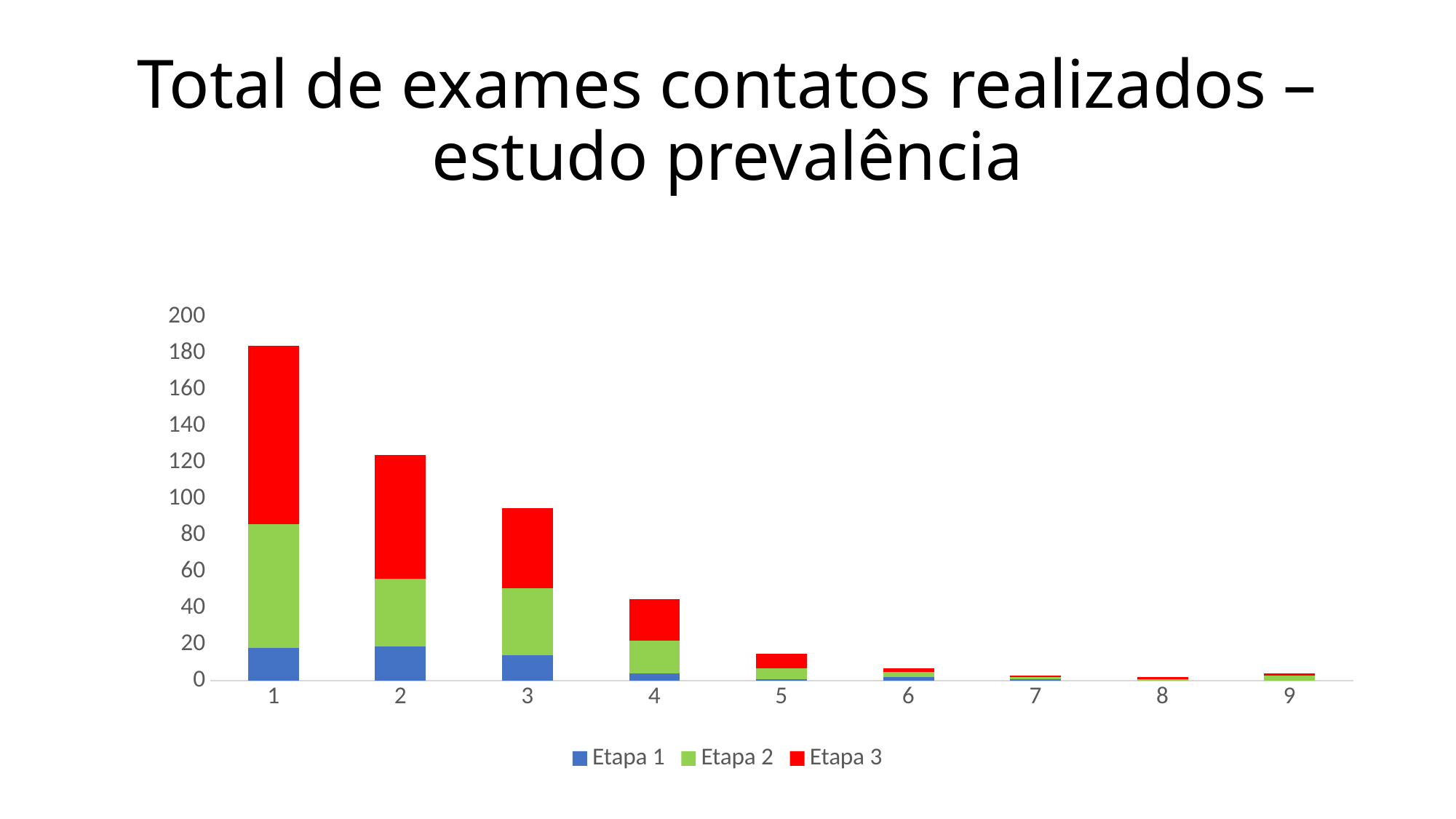
Do the bar totals rise or fall from category 1 to category 5? fall Which colour represents Etapa 3 in the chart? red Which category has the tallest stacked bar? 1 Is the total of the stacked bar for category 5 greater or less than 20? less Which stacked bar is taller, category 2 or category 3? 2 Is the total of the stacked bar for category 1 greater or less than 160? greater Is the total of the stacked bar for category 2 greater or less than 100? greater What kind of chart is shown on the slide? stacked bar chart How many series does the legend list? 3 How many categories are shown on the x axis of the chart? 9 Which category has the shortest stacked bar? 8